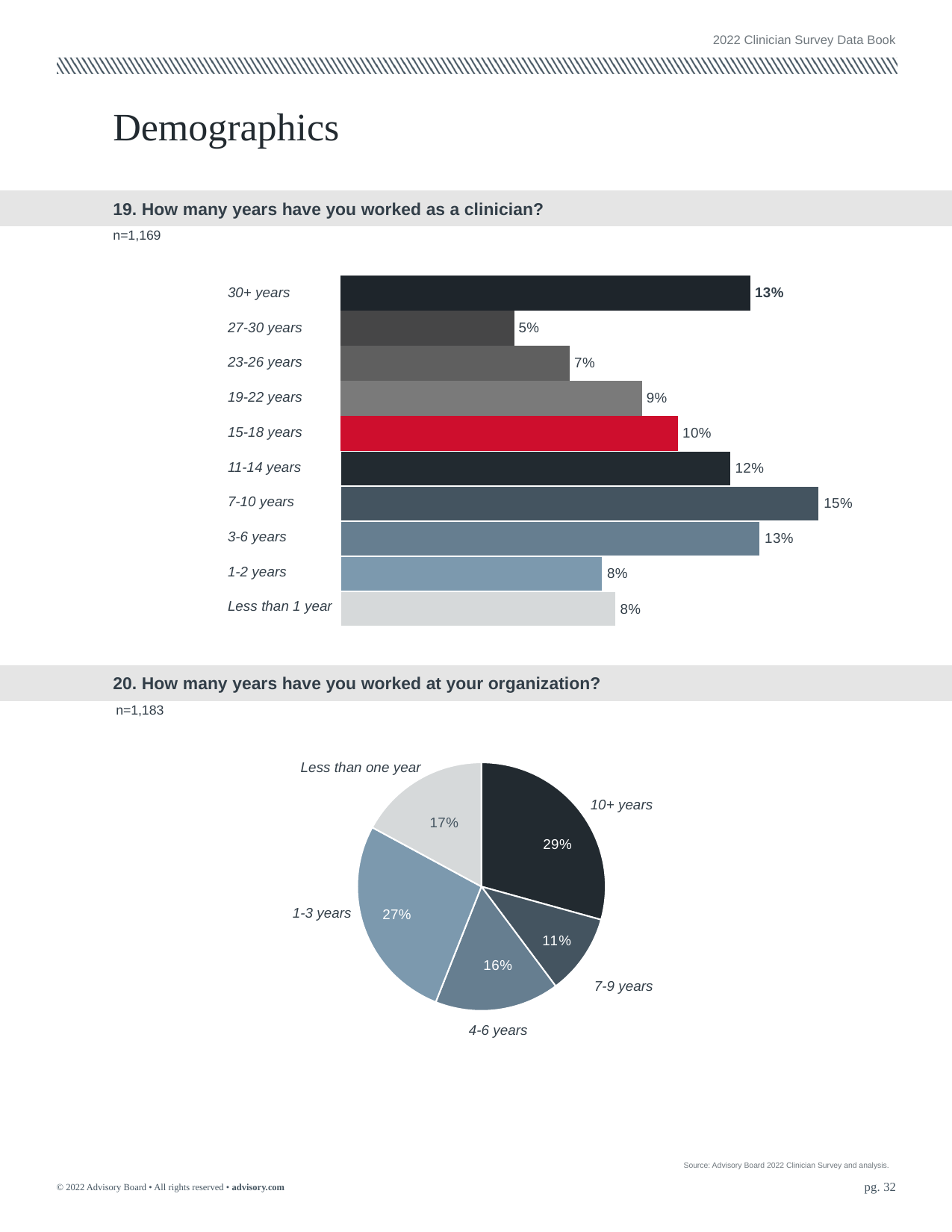
In the bar chart for question 19 (years worked as a clinician), which is larger: the value for 19-22 years or the value for 23-26 years? 19-22 years In the bar chart for question 19 (years worked as a clinician), what percentage of respondents have worked 27-30 years? 5% In the bar chart for question 19 (years worked as a clinician), which category has the highest percentage? 7-10 years What type of chart is used for question 19 (years worked as a clinician)? Bar chart In the bar chart for question 19 (years worked as a clinician), which category has the lowest percentage? 27-30 years In the bar chart for question 19 (years worked as a clinician), which bar is coloured red? 15-18 years In the pie chart for question 20 (years worked at your organization), which category has the smallest share? 7-9 years How many slices are in the pie chart for question 20 (years worked at your organization)? 5 In the pie chart for question 20 (years worked at your organization), what share of respondents have worked 10+ years? 29% How many categories are shown in the bar chart for question 19 (years worked as a clinician)? 10 In the bar chart for question 19 (years worked as a clinician), what is the difference between the percentages for 7-10 years and 11-14 years? 3% In the bar chart for question 19 (years worked as a clinician), what percentage of respondents have worked 7-10 years? 15%